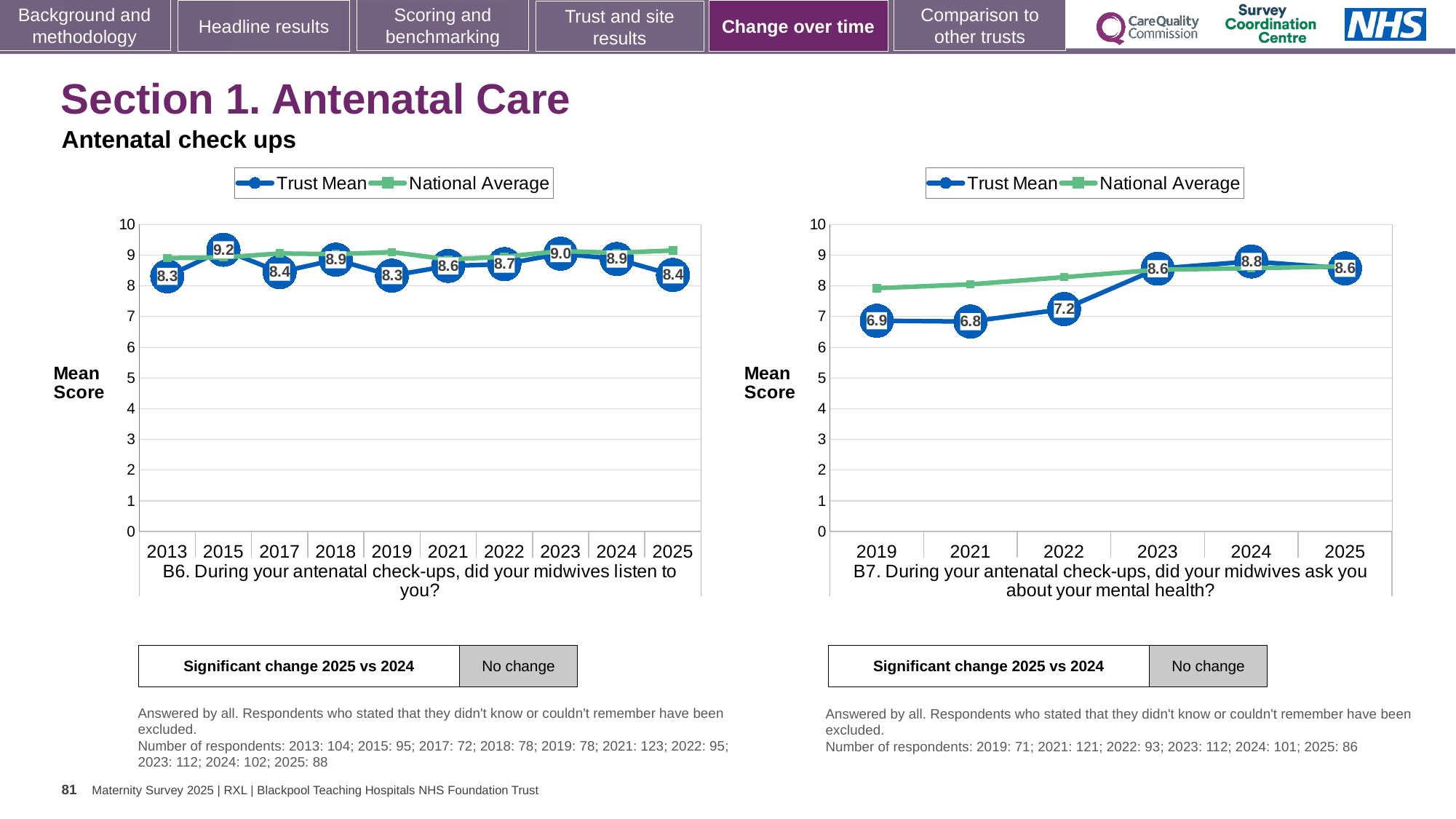
In the right chart (B7), what is the difference between the Trust Mean scores for 2023 and 2021? 1.8 What kind of chart is the left chart (B6)? Line chart How many series does the legend of the right chart (B7) list? 2 In the right chart (B7), what is the Trust Mean score for 2022? 7.2 In the left chart (B6), how many years are shown on the x axis? 10 In the left chart (B6), what is the difference between the Trust Mean scores for 2015 and 2025? 0.8 In the right chart (B7), which year has the lowest Trust Mean score? 2021 In the left chart (B6), which year has the highest Trust Mean score? 2015 In the right chart (B7), is the Trust Mean for 2019 larger or smaller than the National Average for 2019? smaller In the left chart (B6), is the National Average for 2025 greater or less than 9? greater In the right chart (B7), which year has the highest Trust Mean score? 2024 In the left chart (B6), what is the Trust Mean score for 2025? 8.4